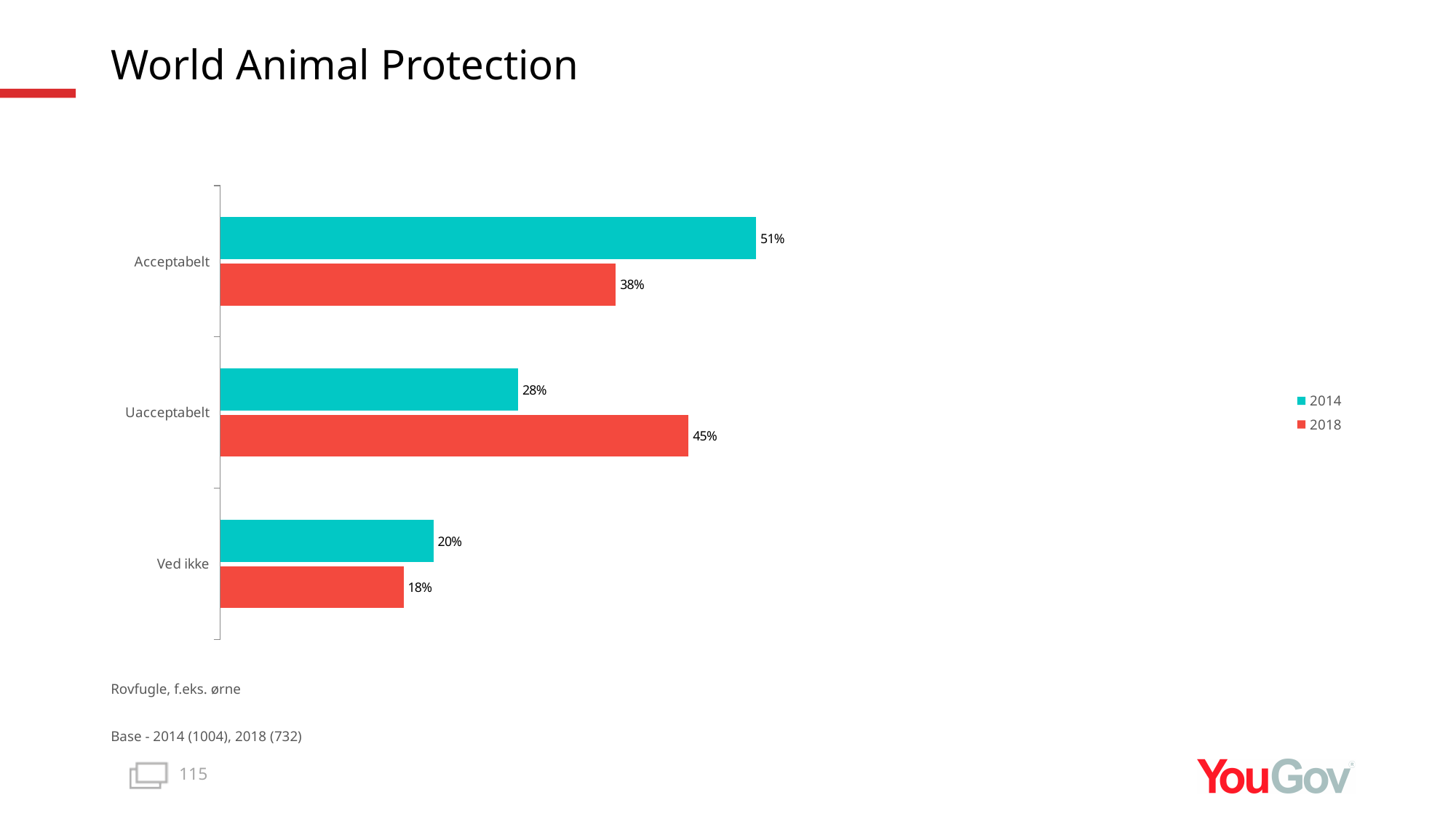
How many series does the legend list? 2 What is the difference between the 2018 and 2014 values for Uacceptabelt? 17% What kind of chart is shown on the slide? Bar chart What is the value for Acceptabelt in 2018? 38% What is the difference between the 2014 and 2018 values for Acceptabelt? 13% Which is larger for Uacceptabelt: the 2014 value or the 2018 value? 2018 What is the value for Uacceptabelt in 2018? 45% How many categories are shown on the chart? 3 Which category has the highest value in the 2014 series? Acceptabelt What is the value for Acceptabelt in 2014? 51% What is the value for Ved ikke in 2014? 20% Which category has the lowest value in the 2018 series? Ved ikke